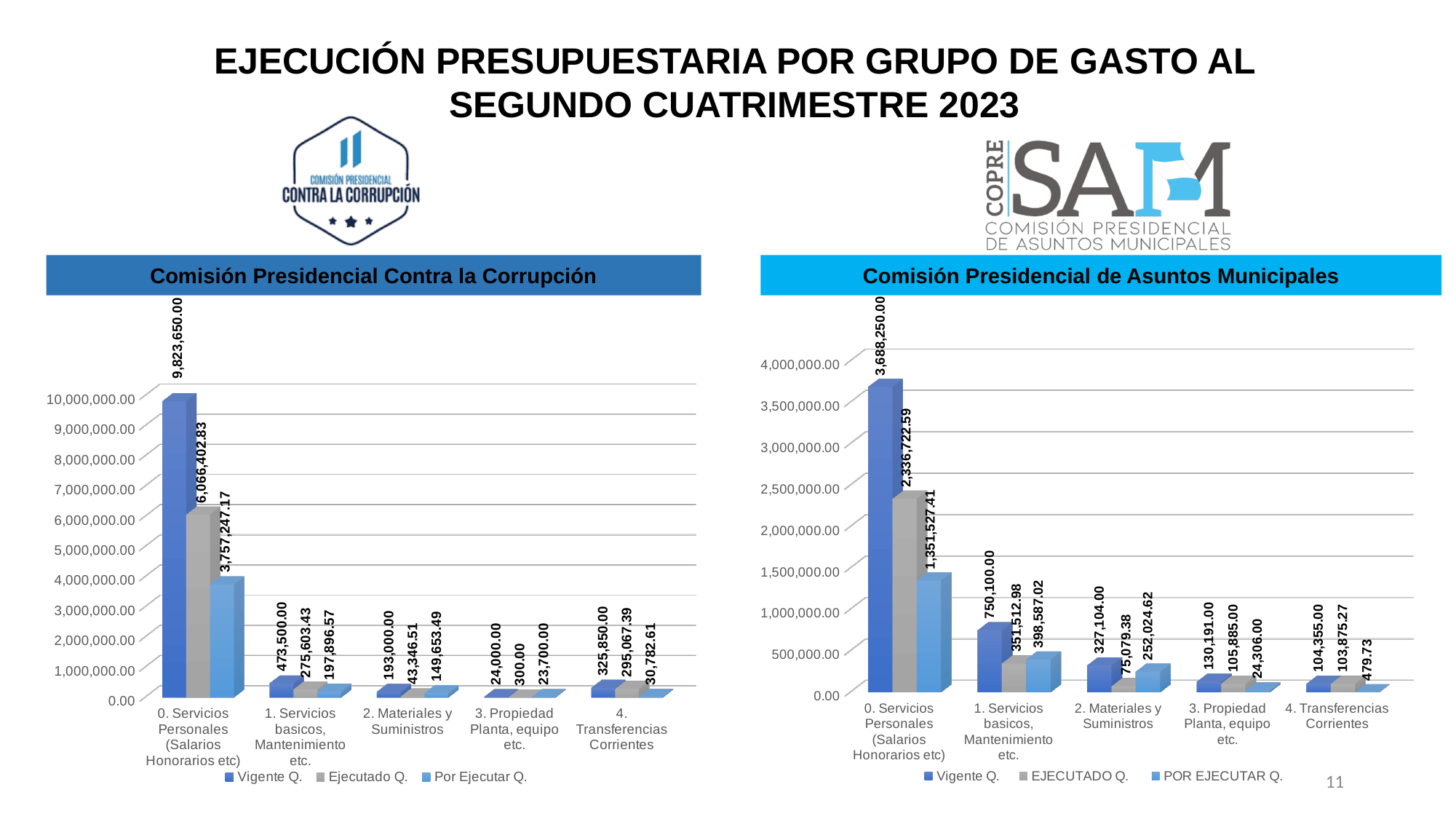
In the chart titled 'Comisión Presidencial de Asuntos Municipales', what is the EJECUTADO Q. value for '0. Servicios Personales (Salarios Honorarios etc)'? 2,336,722.59 In the chart titled 'Comisión Presidencial de Asuntos Municipales', which category has the highest Vigente Q. value? 0. Servicios Personales (Salarios Honorarios etc) In the chart titled 'Comisión Presidencial Contra la Corrupción', how many series does the legend list? 3 In the chart titled 'Comisión Presidencial Contra la Corrupción', what is the Ejecutado Q. value for '3. Propiedad Planta, equipo etc.'? 300.00 In the chart titled 'Comisión Presidencial Contra la Corrupción', what is the Ejecutado Q. value for '4. Transferencias Corrientes'? 295,067.39 In the chart titled 'Comisión Presidencial de Asuntos Municipales', what is the POR EJECUTAR Q. value for '4. Transferencias Corrientes'? 479.73 What kind of chart is the one titled 'Comisión Presidencial de Asuntos Municipales'? Bar chart In the chart titled 'Comisión Presidencial Contra la Corrupción', what is the Vigente Q. value for '0. Servicios Personales (Salarios Honorarios etc)'? 9,823,650.00 In the chart titled 'Comisión Presidencial de Asuntos Municipales', how many categories are shown on the x axis? 5 In the chart titled 'Comisión Presidencial Contra la Corrupción', which category has the lowest Vigente Q. value? 3. Propiedad Planta, equipo etc. In the chart titled 'Comisión Presidencial de Asuntos Municipales', which is larger for '1. Servicios basicos, Mantenimiento etc.': the EJECUTADO Q. value or the POR EJECUTAR Q. value? POR EJECUTAR Q. In the chart titled 'Comisión Presidencial Contra la Corrupción', what is the difference between the Vigente Q. and Ejecutado Q. values for '1. Servicios basicos, Mantenimiento etc.'? 197,896.57